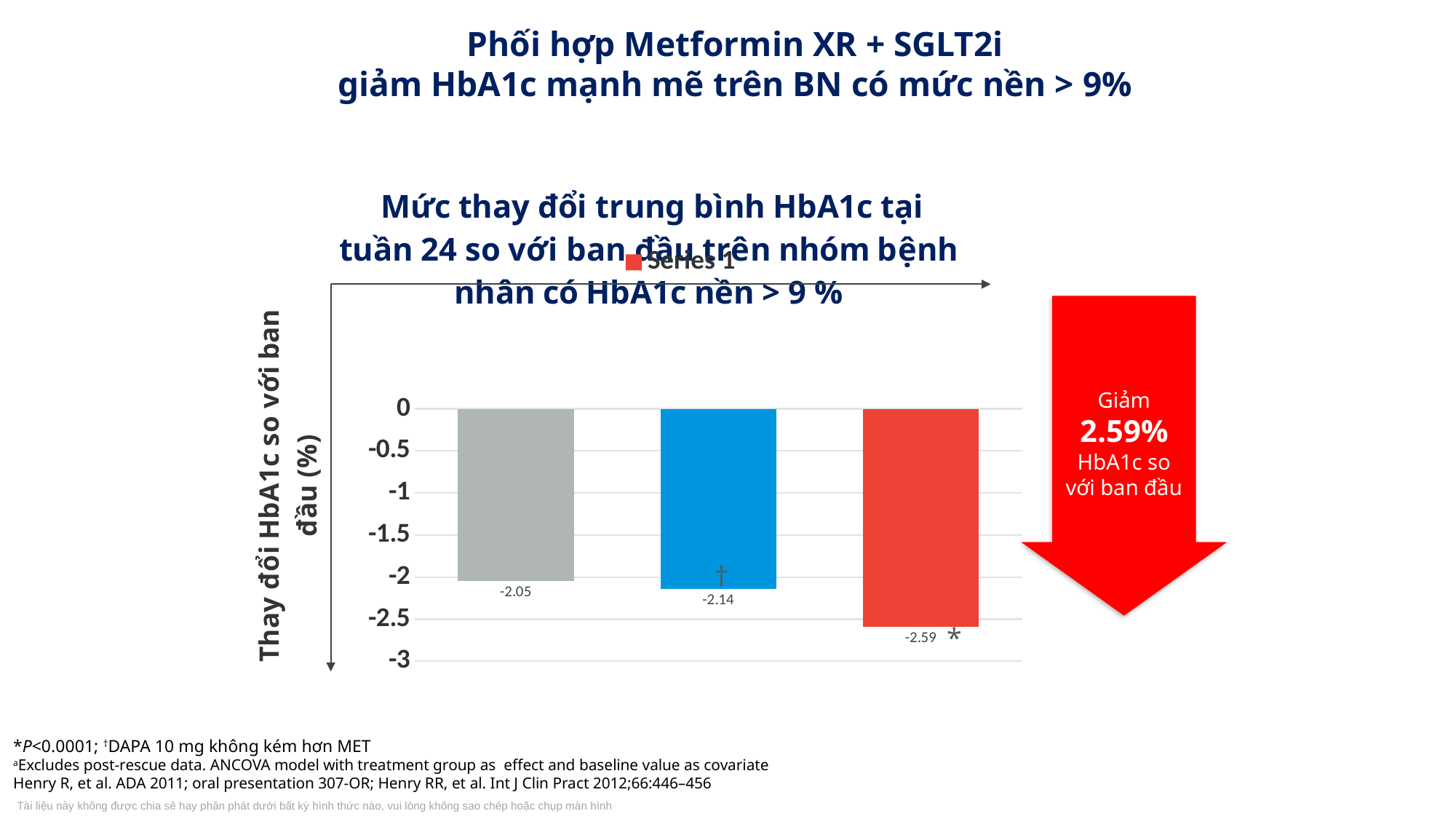
What is the difference between the blue bar's value and the gray bar's value? 0.09 Which bar shows a larger reduction in HbA1c, the blue bar or the red bar? The red bar What kind of chart is shown on the slide? Bar chart What is the difference between the red bar's value and the gray bar's value? 0.54 Which bar has the highest (least negative) value? The gray bar (first bar), -2.05 What is the value shown on the blue bar (middle bar)? -2.14 What is the legend entry shown above the chart? Series 1 How many series does the legend list? 1 What is the value shown on the red bar (third bar from the left)? -2.59 Which bar has the lowest (most negative) value? The red bar (third bar), -2.59 What is the value shown on the gray bar (first bar from the left)? -2.05 How many bars are plotted in the chart? 3